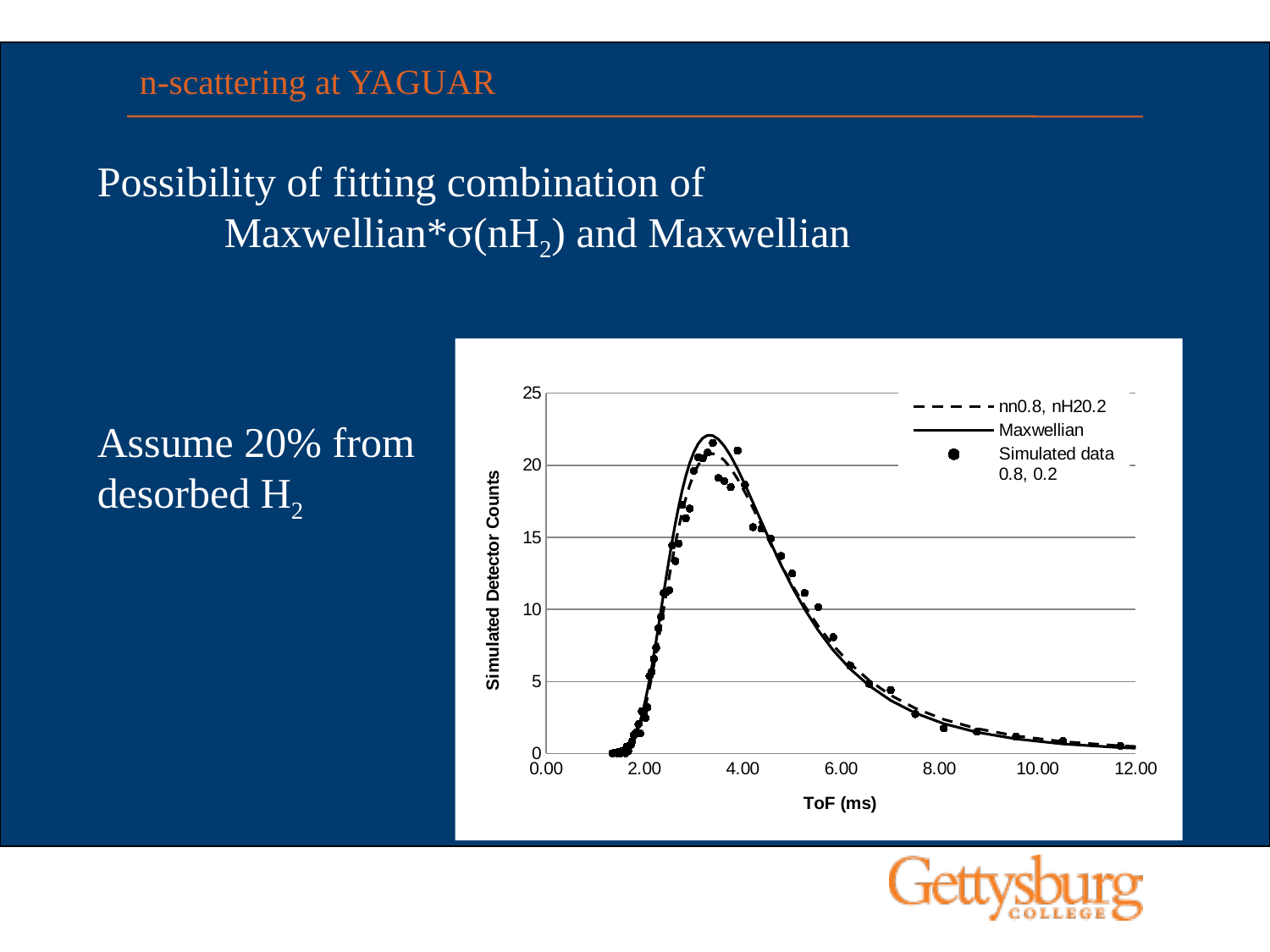
Is the peak value of the Maxwellian curve greater or less than 20? greater What is the highest tick value shown on the y axis of the chart? 25 What is the title of the y axis of the chart? Simulated Detector Counts How many series does the chart's legend list? 3 What kind of chart is shown on the slide? line chart Is the value of the Maxwellian curve at ToF 6.00 ms greater or less than 10? less What is the title of the x axis of the chart? ToF (ms) Do the values of the Maxwellian curve rise or fall as ToF increases from 2.00 ms to 3.00 ms? rise Do the values of the Maxwellian curve rise or fall as ToF increases from 4.00 ms to 12.00 ms? fall Is the value of the Maxwellian curve at ToF 10.00 ms greater or less than 5? less